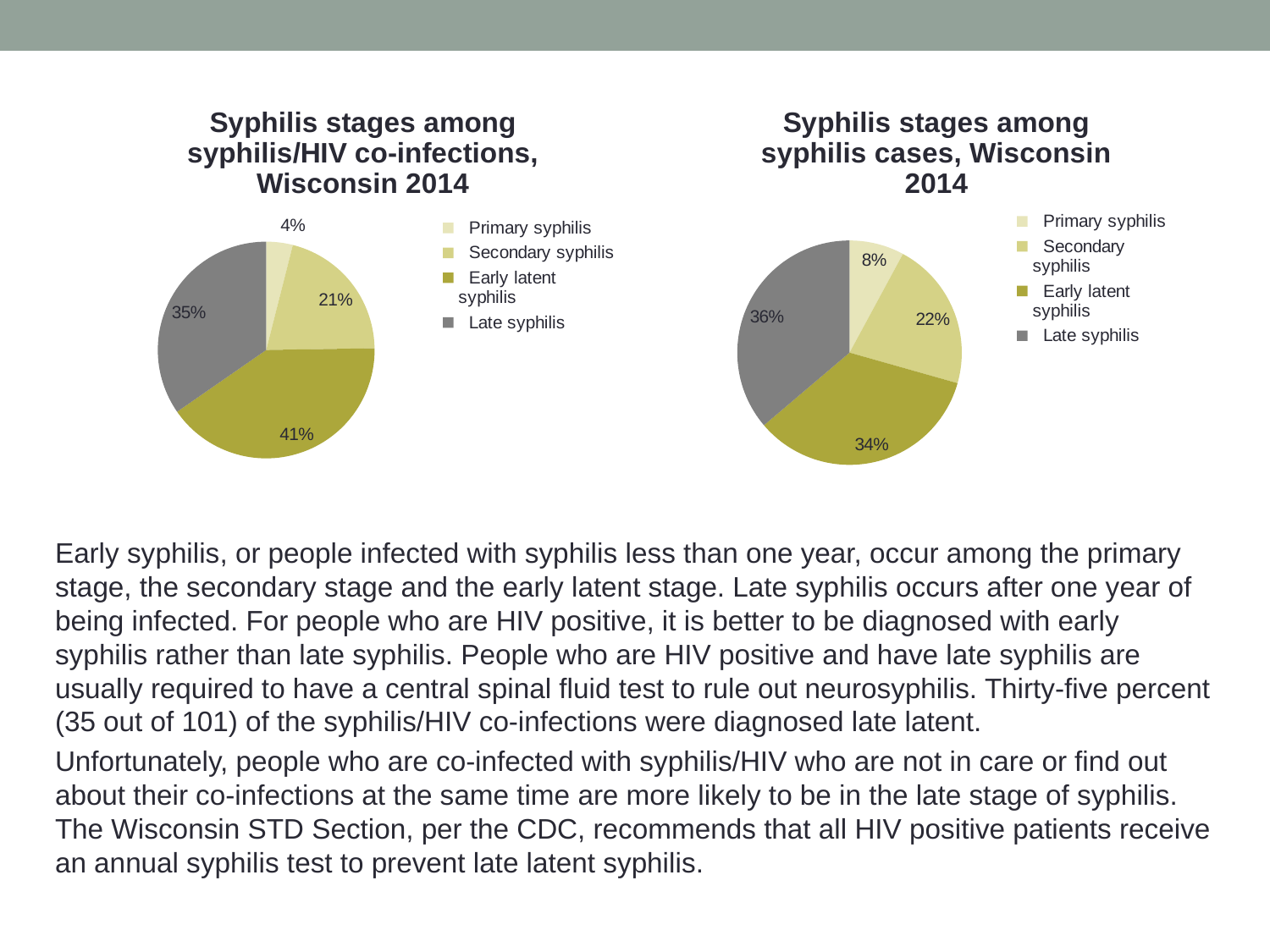
What type of chart is the 'Syphilis stages among syphilis cases, Wisconsin 2014' chart? Pie chart How many entries does the legend of the 'Syphilis stages among syphilis cases, Wisconsin 2014' chart list? 4 In the 'Syphilis stages among syphilis cases, Wisconsin 2014' chart, which stage has the smallest share? Primary syphilis In the 'Syphilis stages among syphilis/HIV co-infections, Wisconsin 2014' chart, what is the difference in percentage points between early latent syphilis and late syphilis? 6 In the 'Syphilis stages among syphilis/HIV co-infections, Wisconsin 2014' chart, which stage has the largest share? Early latent syphilis In the 'Syphilis stages among syphilis/HIV co-infections, Wisconsin 2014' chart, what colour is the late syphilis slice? Gray In the 'Syphilis stages among syphilis/HIV co-infections, Wisconsin 2014' chart, what share is primary syphilis? 4% In the 'Syphilis stages among syphilis/HIV co-infections, Wisconsin 2014' chart, what share is early latent syphilis? 41% How many slices does the 'Syphilis stages among syphilis/HIV co-infections, Wisconsin 2014' chart have? 4 In the 'Syphilis stages among syphilis cases, Wisconsin 2014' chart, which is larger: the share for early latent syphilis or the share for secondary syphilis? Early latent syphilis In the 'Syphilis stages among syphilis cases, Wisconsin 2014' chart, what share is secondary syphilis? 22% In the 'Syphilis stages among syphilis cases, Wisconsin 2014' chart, what share is late syphilis? 36%